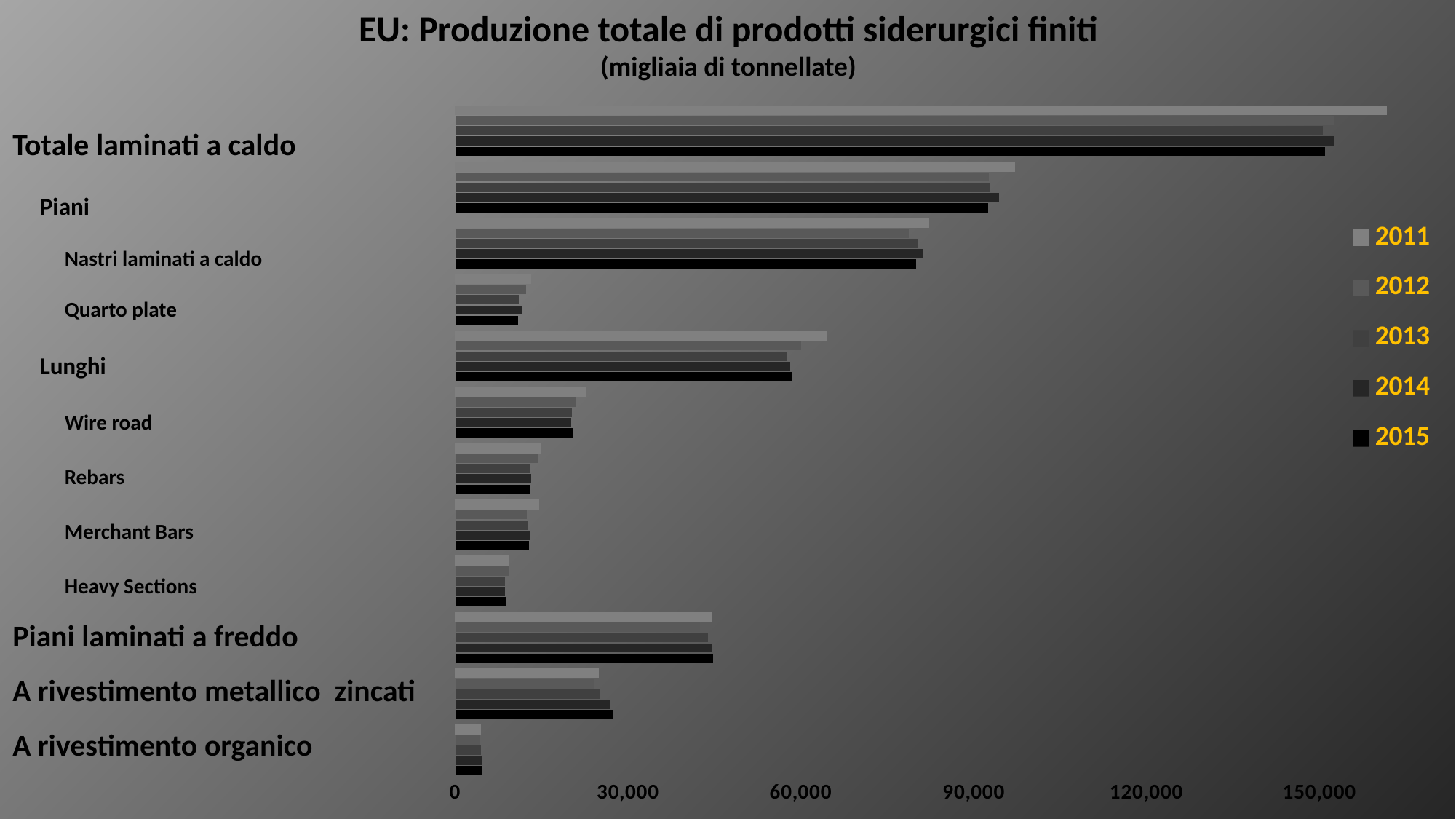
How many categories are shown on the vertical axis of the chart? 12 Is the 2011 value for Totale laminati a caldo greater or less than 150,000? greater Is the 2015 value for Piani laminati a freddo greater or less than 30,000? greater Is the 2015 value for Nastri laminati a caldo greater or less than 90,000? less What kind of chart is shown on the slide? Bar chart Which year is shown in yellow text at the bottom of the legend? 2015 Which category has the lowest production values? A rivestimento organico Which category has the highest production values? Totale laminati a caldo How many series does the legend list? 5 Which is larger, the 2015 value for Piani or the 2015 value for Lunghi? Piani